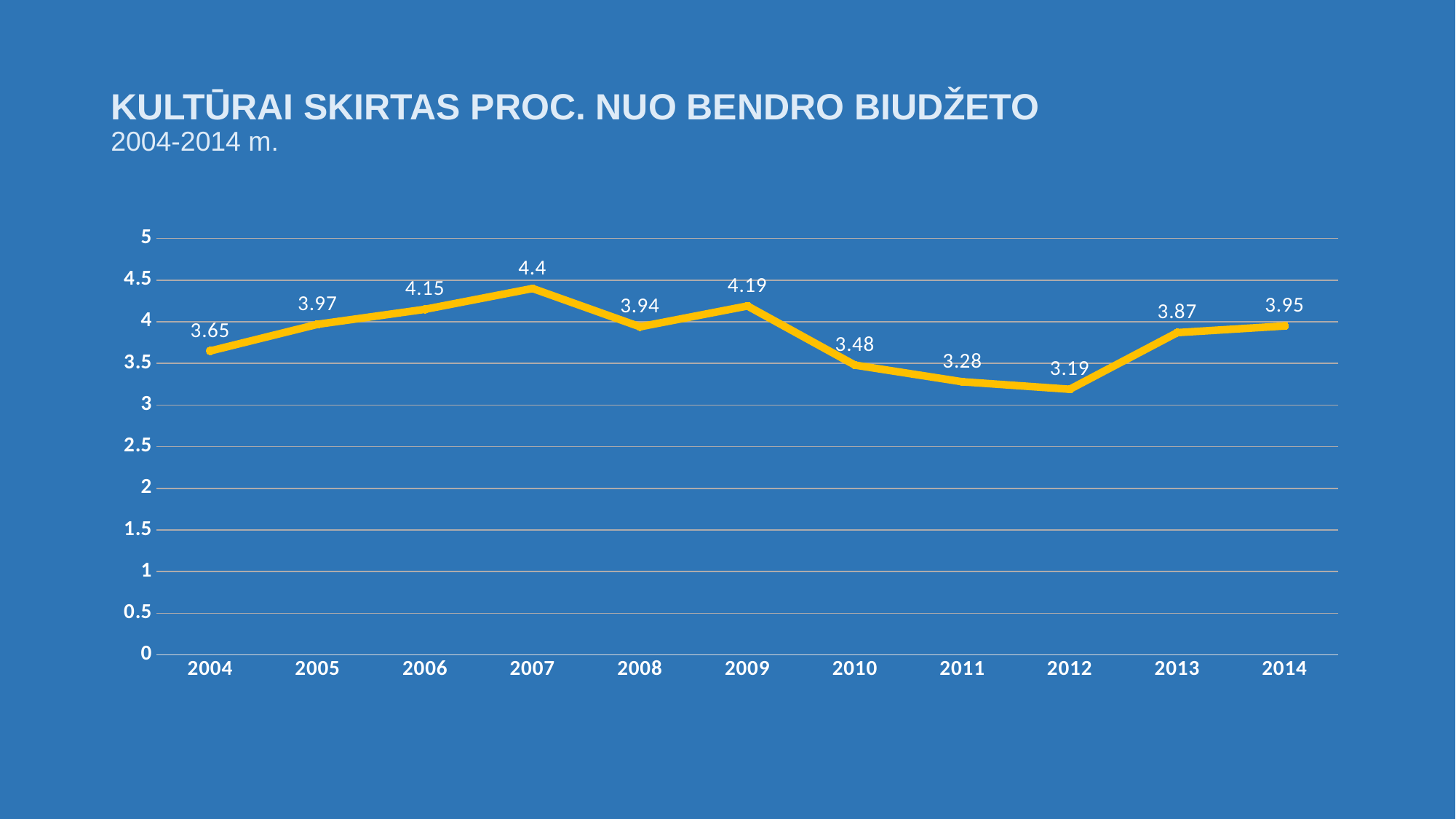
What kind of chart is shown on the slide? line chart What is the value for 2012? 3.19 Which year has the highest value? 2007 Do the values rise or fall from 2009 to 2012? fall Which year has the lowest value? 2012 What is the title of the chart? KULTŪRAI SKIRTAS PROC. NUO BENDRO BIUDŽETO What is the difference between the values for 2007 and 2012? 1.21 How many years are plotted on the chart? 11 Is the value for 2010 greater or less than 4? less Which is larger, the value for 2009 or the value for 2013? 2009 What is the value for 2007? 4.4 What is the value for 2004? 3.65